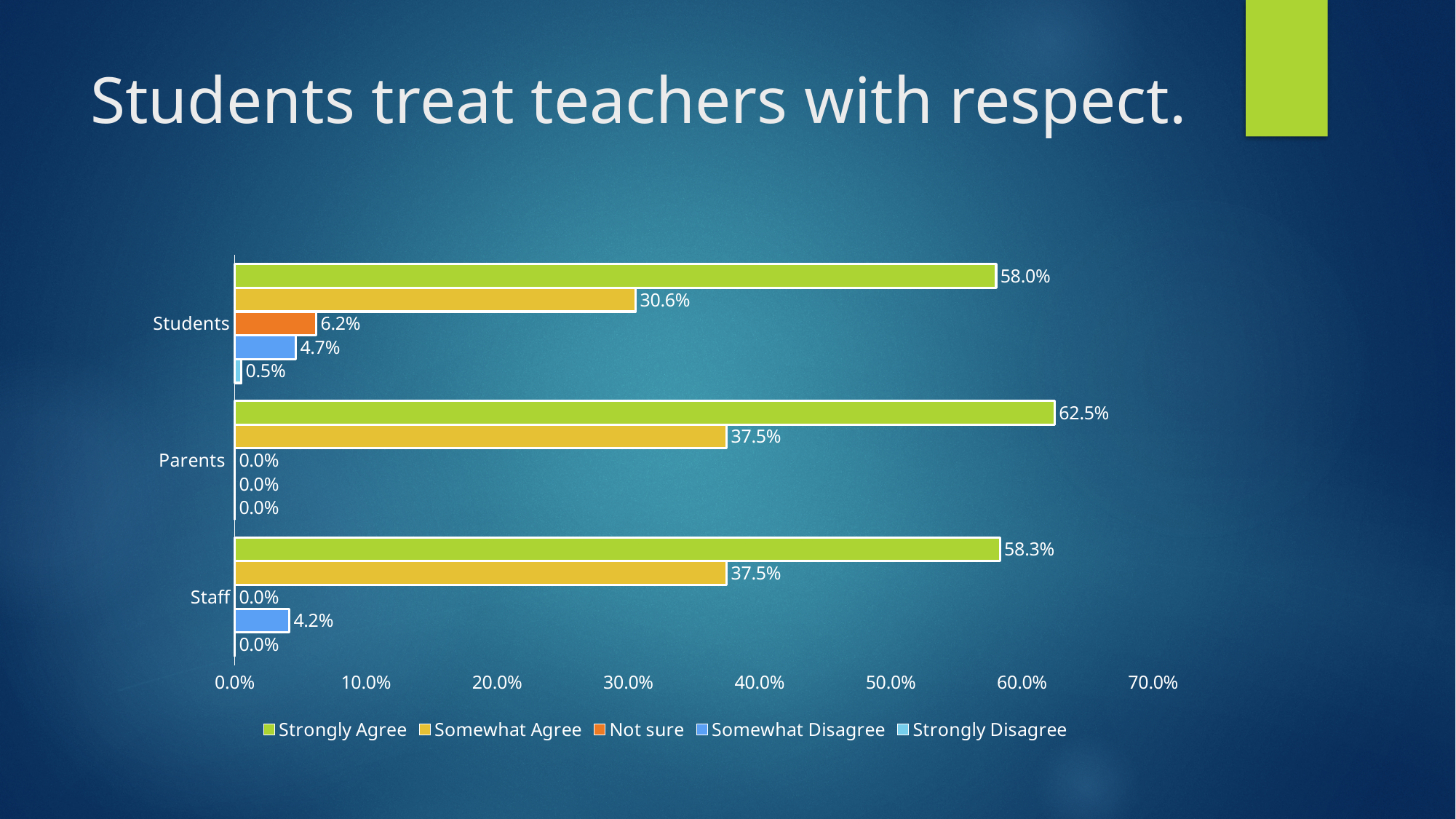
What percentage of Students responded Not sure? 6.2% What is the difference between the Strongly Agree percentages for Parents and Students? 4.5% Is the Somewhat Agree value for Students greater or less than 40.0%? less What kind of chart is shown on the slide? Bar chart Which is larger: the Somewhat Disagree value for Students or for Staff? Students How many groups are shown on the vertical axis? 3 How many series does the legend list? 5 What percentage of Parents responded Somewhat Agree? 37.5% What percentage of Staff responded Somewhat Disagree? 4.2% Which group has the highest Strongly Agree percentage? Parents Which group has the lowest Somewhat Agree percentage? Students What percentage of Students responded Strongly Agree? 58.0%